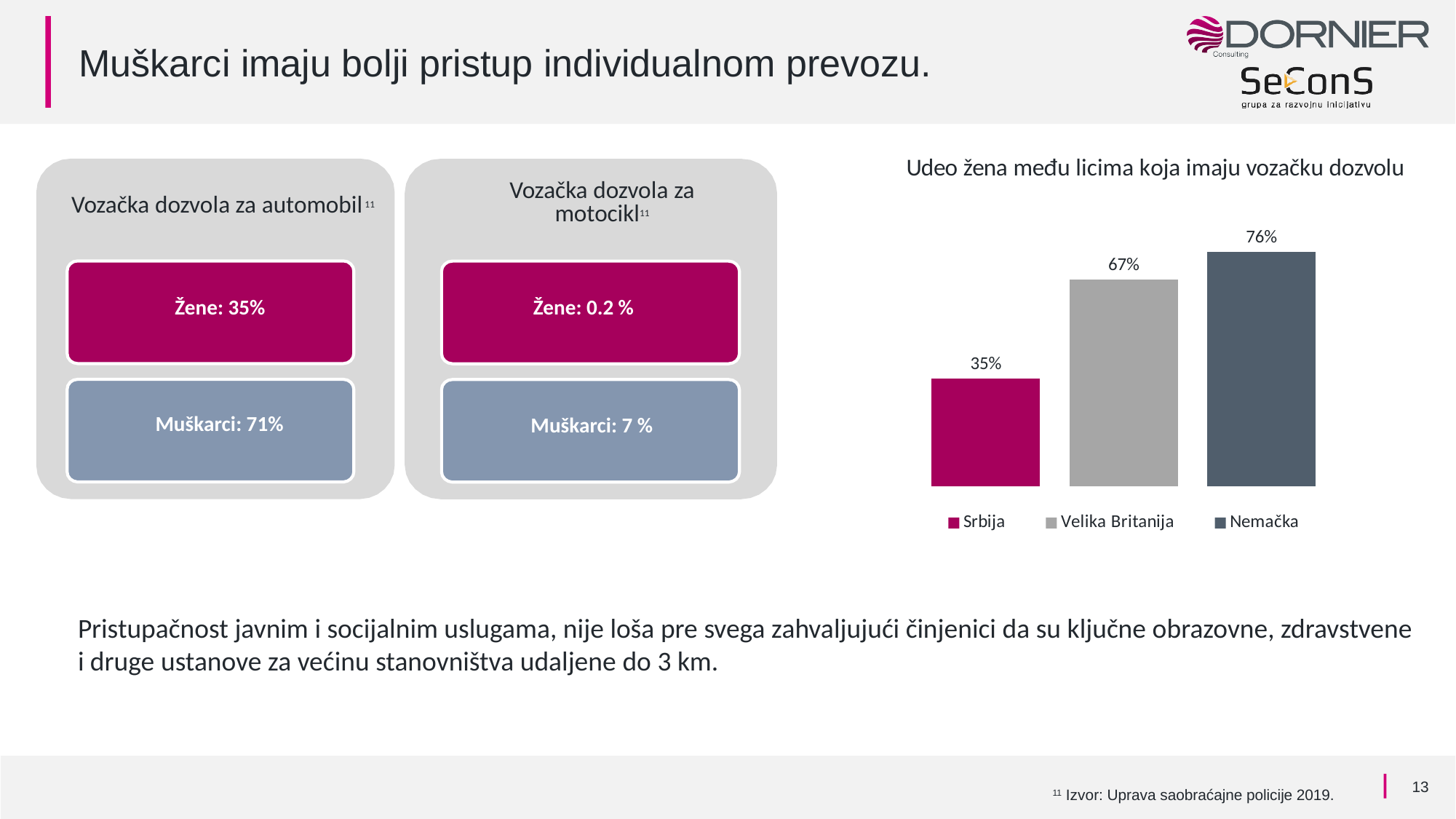
What is the difference between the values for Nemačka and Srbija? 41% How many bars are plotted in the chart? 3 How many entries does the chart legend list? 3 What is the difference between the values for Velika Britanija and Srbija? 32% What is the value for Srbija in the chart? 35% What is the title of the chart? Udeo žena među licima koja imaju vozačku dozvolu What kind of chart is shown on the slide? Bar chart What is the value for Velika Britanija in the chart? 67% What is the value for Nemačka in the chart? 76% Which is larger, the value for Velika Britanija or the value for Nemačka? Nemačka Which country has the highest value in the chart? Nemačka Which country has the lowest value in the chart? Srbija